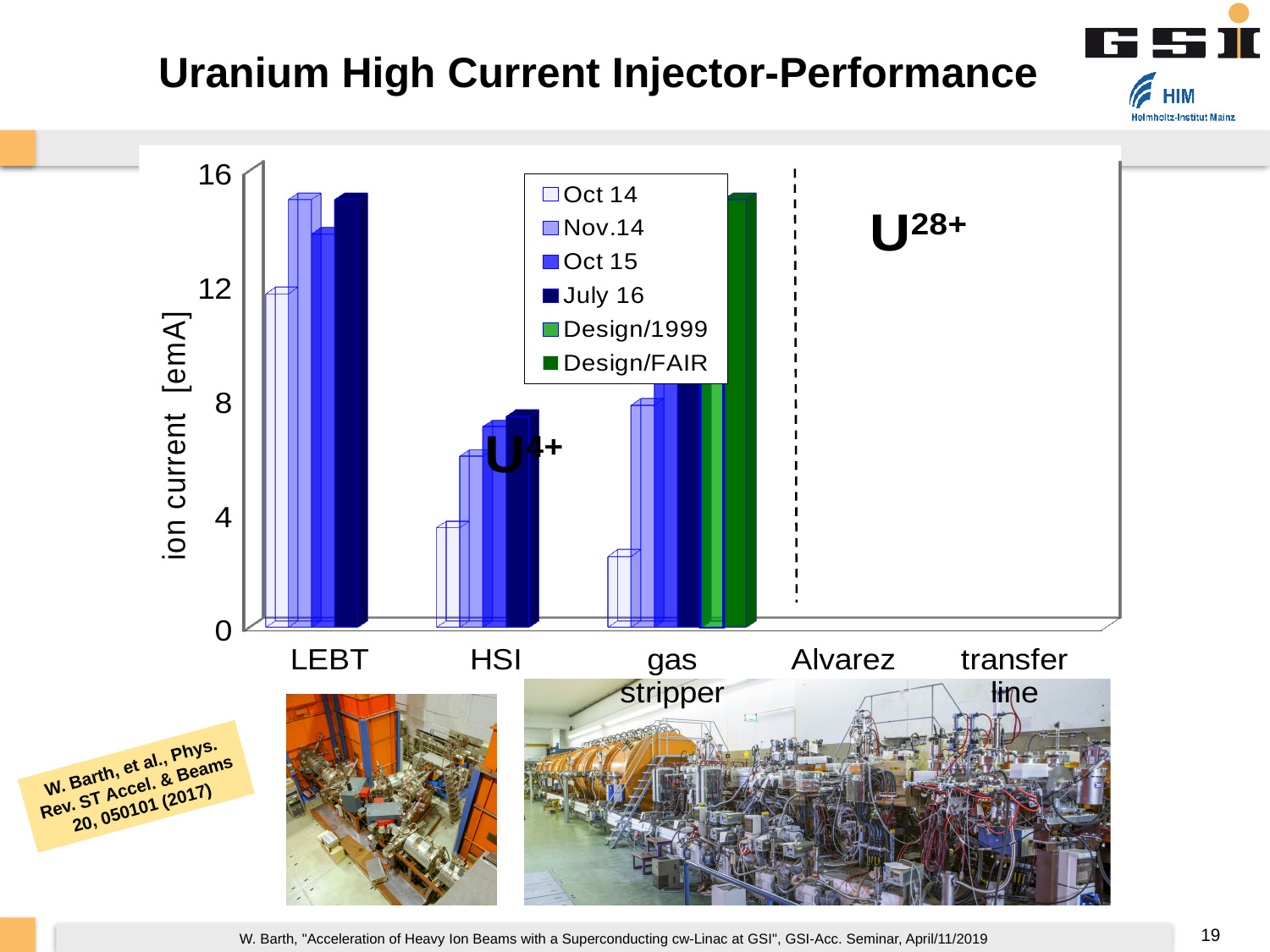
Is the Nov.14 value for LEBT greater or less than 12? greater Is the Oct 14 value for HSI greater or less than 4? less What is the label of the y axis? ion current [emA] How many categories are labelled along the x axis? 5 How many series does the legend list? 6 What kind of chart is shown on the slide? bar chart Is the Design/FAIR value for gas stripper greater or less than 12? greater Which is larger at gas stripper, the Design/1999 value or the Design/FAIR value? Design/FAIR Which is larger, the Oct 14 value for LEBT or the Oct 14 value for HSI? LEBT Which category has the highest Oct 14 value? LEBT Within the HSI category, which series has the lowest value? Oct 14